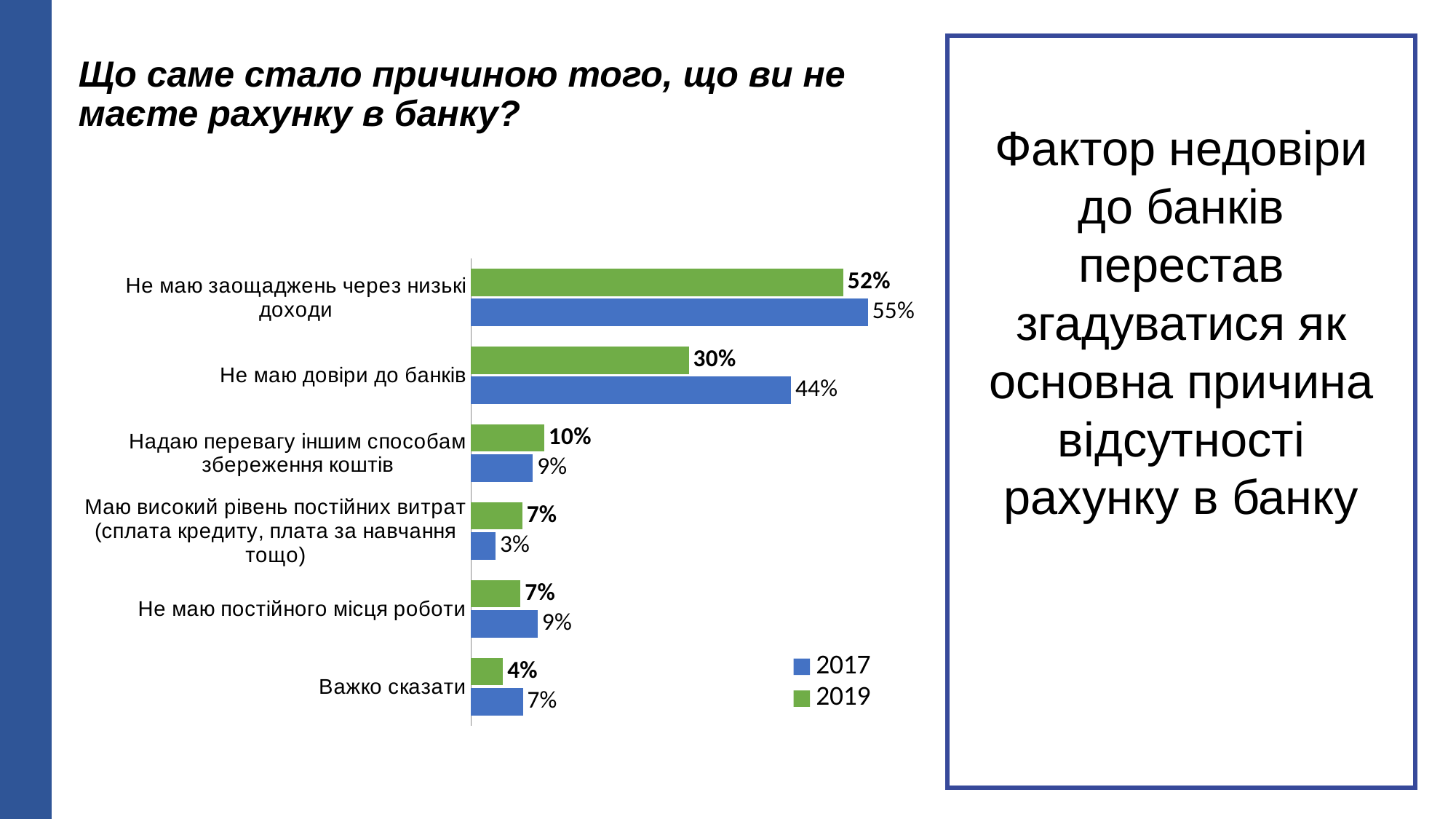
How many categories are shown in the chart? 6 What is the 2017 value for "Не маю заощаджень через низькі доходи"? 55% What is the 2017 value for "Маю високий рівень постійних витрат (сплата кредиту, плата за навчання тощо)"? 3% How many series does the legend list? 2 Which category has the highest 2019 value? Не маю заощаджень через низькі доходи For "Надаю перевагу іншим способам збереження коштів", which year has the larger value, 2017 or 2019? 2019 Which category has the lowest 2017 value? Маю високий рівень постійних витрат (сплата кредиту, плата за навчання тощо) Which colour represents the 2019 series in the chart? Green What is the 2019 value for "Не маю довіри до банків"? 30% What is the 2019 value for "Важко сказати"? 4% What kind of chart is shown on the slide? Bar chart What is the difference between the 2017 and 2019 values for "Не маю довіри до банків"? 14%